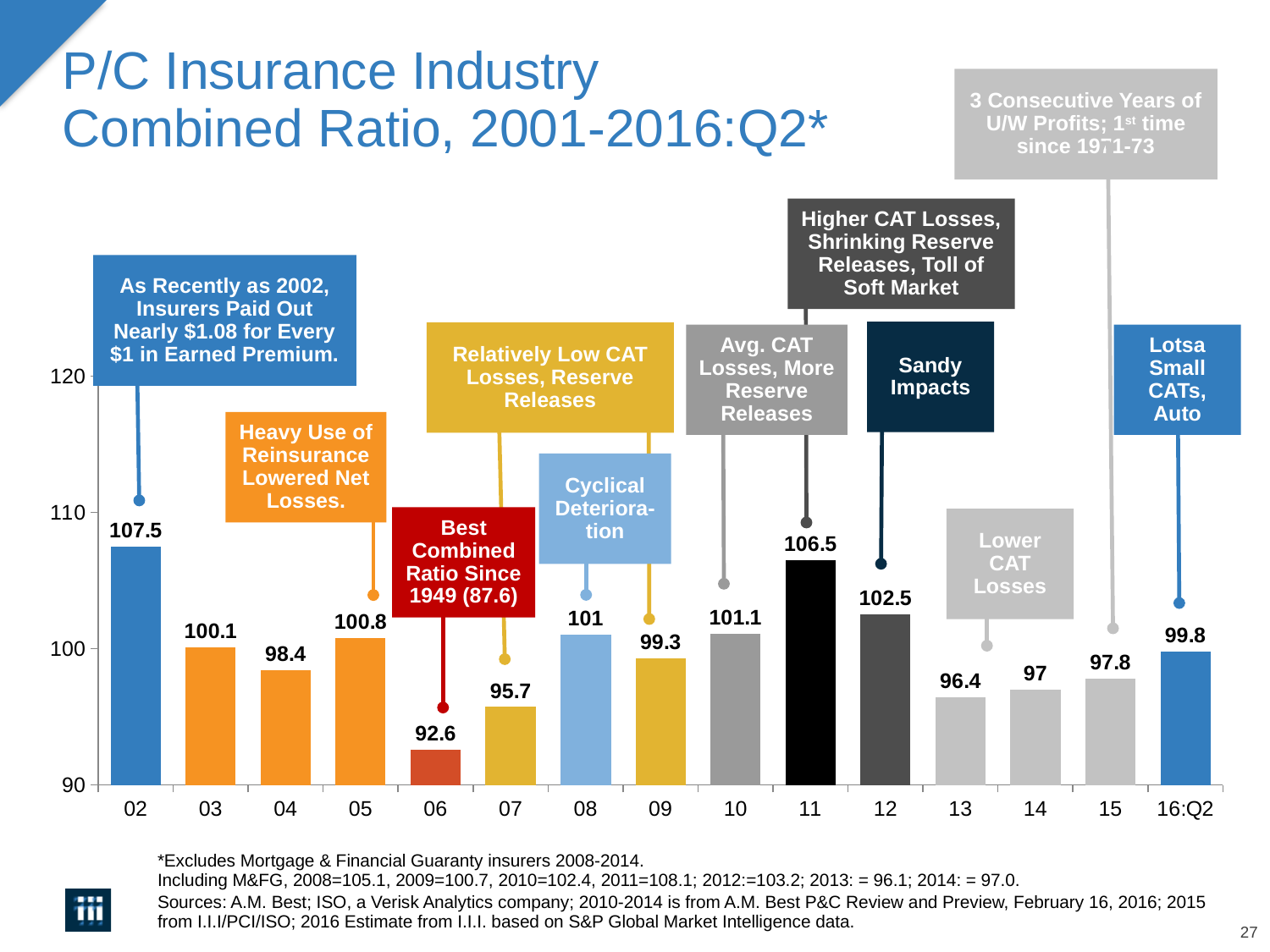
What is the combined ratio shown for 2011 (11)? 106.5 Which is larger, the combined ratio for 2010 (10) or for 2009 (09)? 10 Which year has the highest combined ratio on the chart? 02 Do the combined ratio values rise or fall from 2013 (13) to 2015 (15)? rise Which year has the lowest combined ratio on the chart? 06 What is the combined ratio shown for 2002 (02)? 107.5 What is the difference between the combined ratio for 2012 (12) and 2013 (13)? 6.1 What is the combined ratio shown for 16:Q2? 99.8 Is the combined ratio for 2007 (07) greater or less than 100? less What is the difference between the combined ratio for 2002 (02) and 2006 (06)? 14.9 How many bars (years/periods) are plotted on the chart? 15 What kind of chart is shown on the slide? bar chart